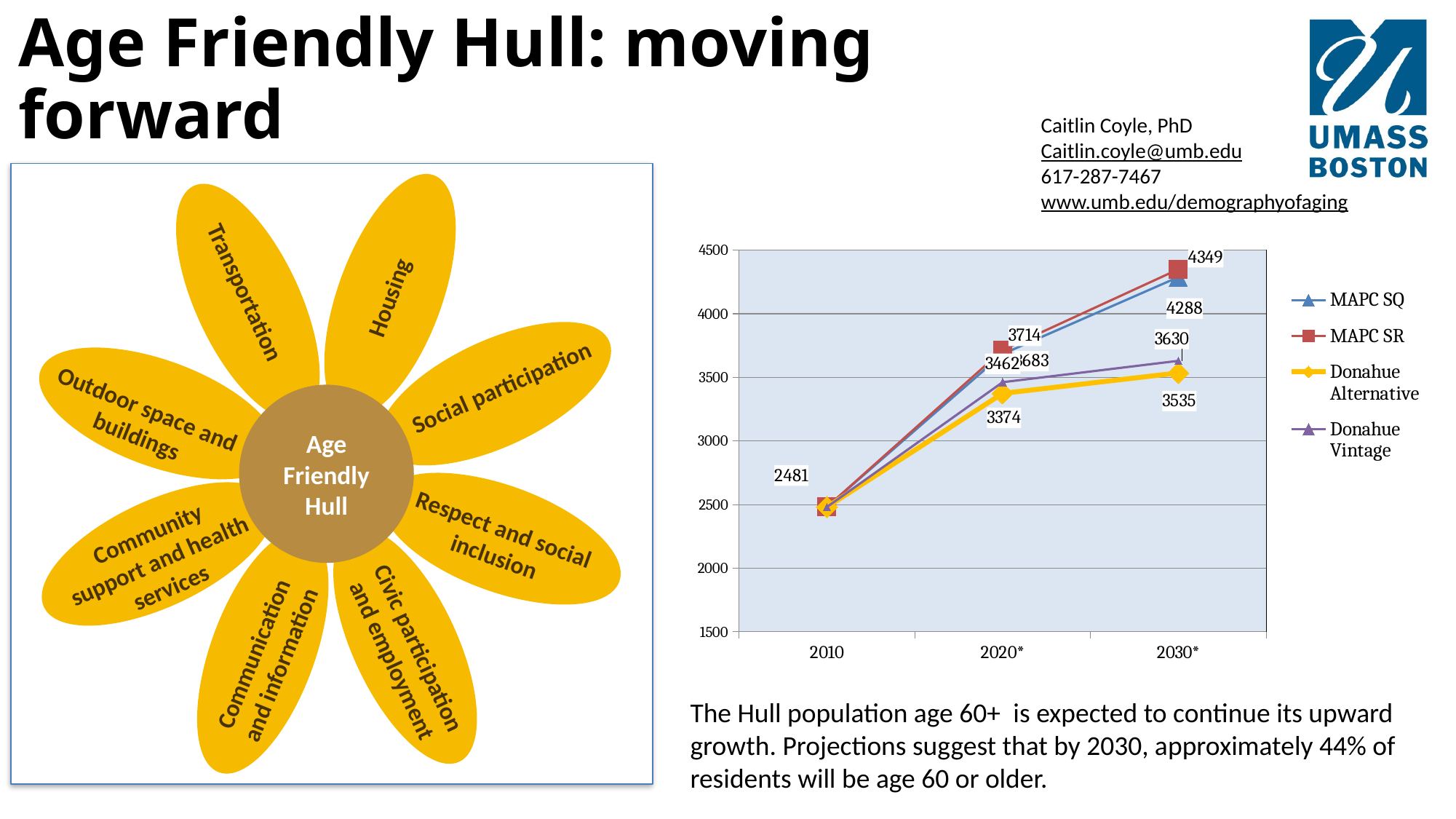
What is the value for Donahue Alternative in 2020*? 3374 What is the value for Donahue Alternative in 2030*? 3535 Which series has the highest value in 2030*? MAPC SR How many series does the legend of the line chart list? 4 What is the value for MAPC SQ in 2030*? 4288 What is the difference between the MAPC SR and MAPC SQ values in 2030*? 61 How many points are shown along the x axis of the line chart? 3 Do the values in the line chart rise or fall from 2010 to 2030*? rise What is the value for MAPC SR in 2020*? 3714 What is the value for MAPC SR in 2030*? 4349 What kind of chart is shown on the right side of the slide? line chart What is the value for Donahue Vintage in 2030*? 3630